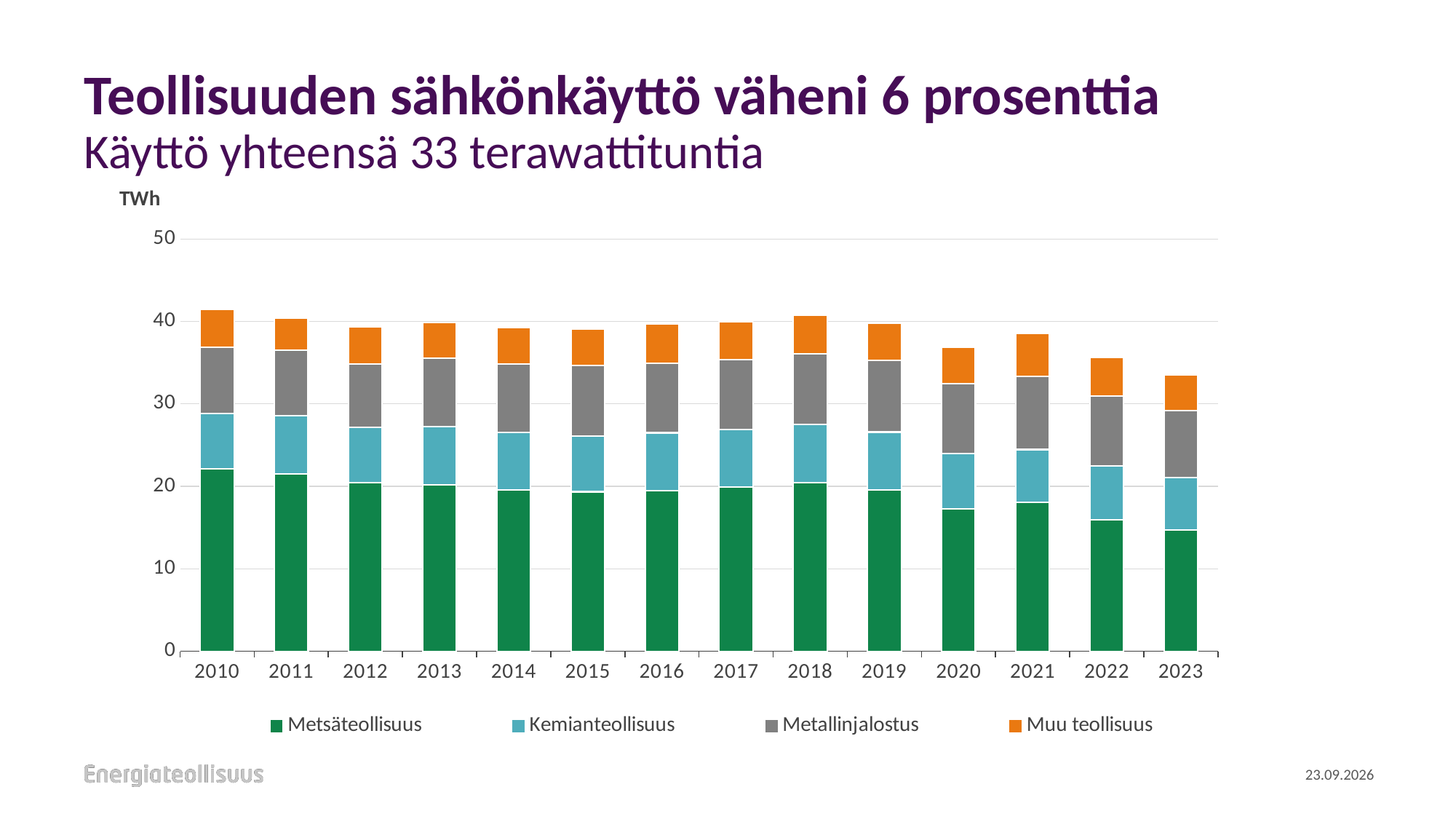
Is the total bar for 2010 greater or less than 40 TWh? greater What kind of chart is shown on the slide? Stacked bar chart Is the Metsäteollisuus value for 2010 greater or less than 20 TWh? greater How many years are shown on the x axis of the chart? 14 Is the Metsäteollisuus value for 2023 greater or less than 20 TWh? less Which is larger, the total bar for 2010 or the total bar for 2023? 2010 Which year has the lowest total industrial electricity use in the chart? 2023 Which series is shown in orange in the chart? Muu teollisuus Does the total industrial electricity use generally rise or fall from 2010 to 2023? Fall How many series does the legend list? 4 What unit is shown on the y axis of the chart? TWh